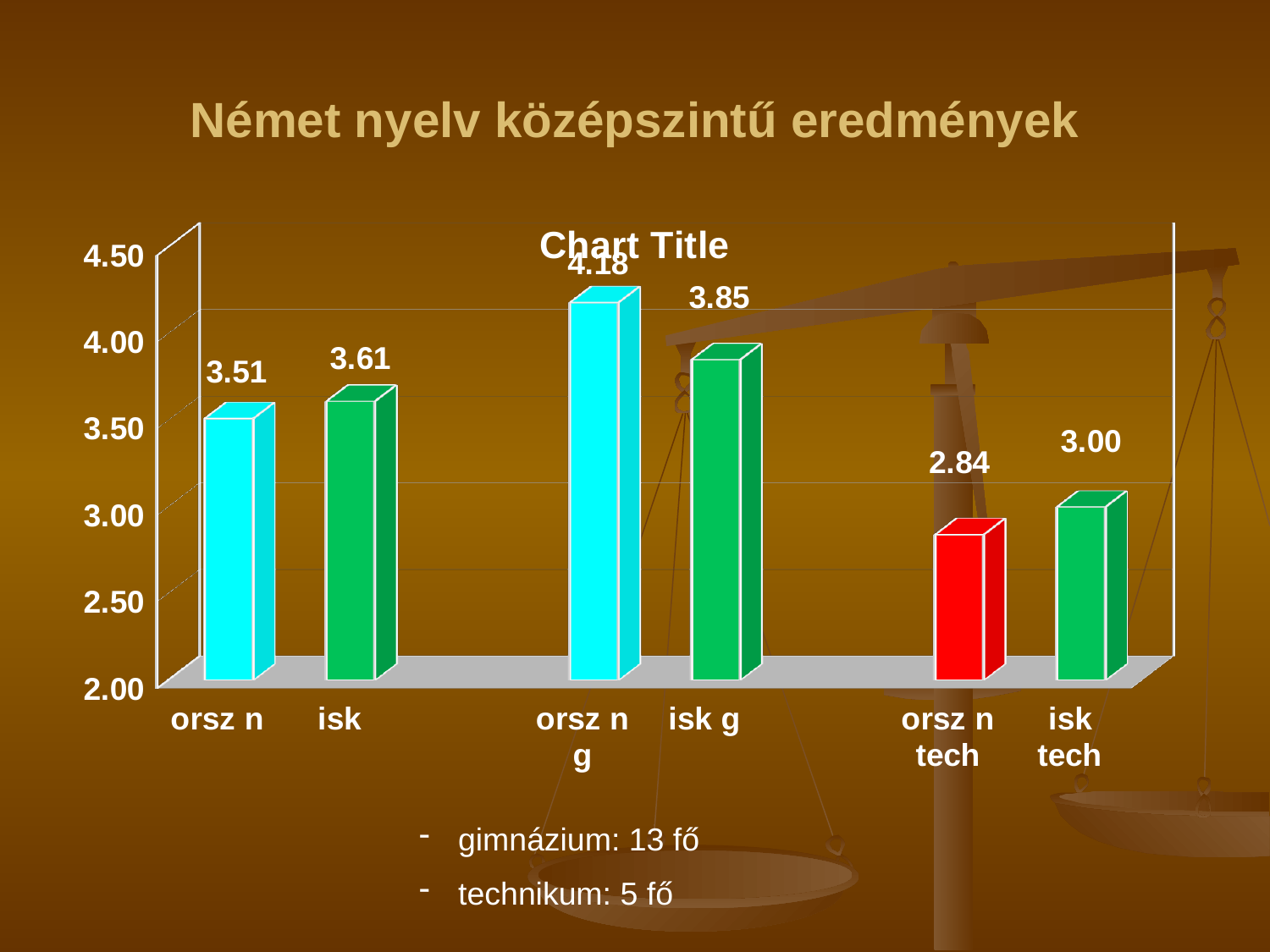
What is the value for "isk g"? 3.85 What is the difference between the values for "orsz n g" and "isk g"? 0.33 What is the value for "isk tech"? 3.00 Which category has the highest value? orsz n g What is the value for "orsz n"? 3.51 Which is larger, the value for "isk tech" or the value for "orsz n tech"? isk tech What is the value for "orsz n tech"? 2.84 Is the value for "orsz n g" greater or less than 4.00? greater How many bars are shown in the chart? 6 What is the difference between the values for "isk" and "orsz n"? 0.10 What kind of chart is shown on the slide? bar chart Which category has the lowest value? orsz n tech